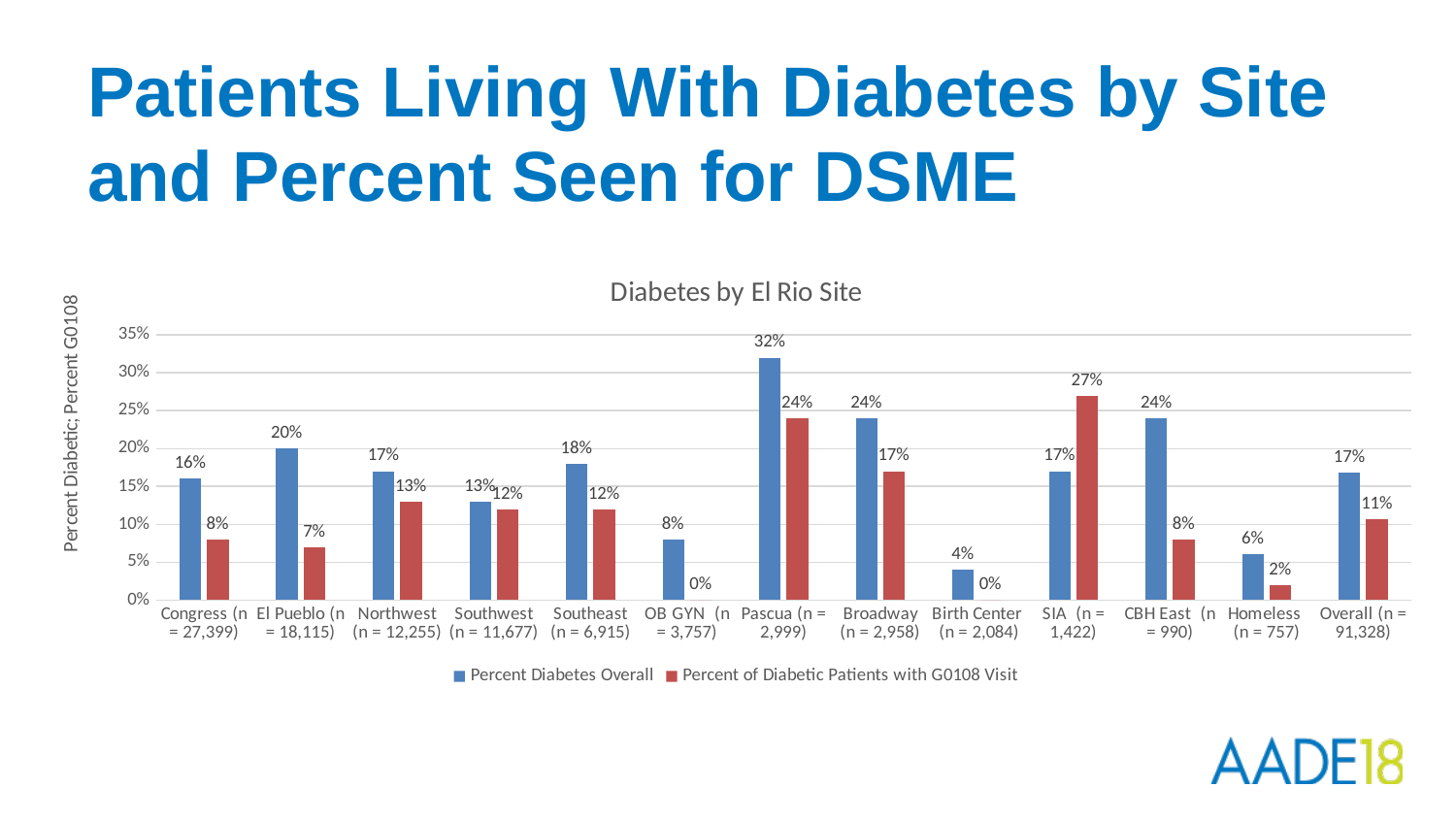
What kind of chart is shown on the slide? Bar chart Which site has the lowest Percent Diabetes Overall? Birth Center Which is larger for SIA: Percent Diabetes Overall or Percent of Diabetic Patients with G0108 Visit? Percent of Diabetic Patients with G0108 Visit What is the Percent of Diabetic Patients with G0108 Visit value for SIA? 27% How many site categories are shown on the x axis? 13 What is the Percent Diabetes Overall value for Pascua? 32% What is the Percent of Diabetic Patients with G0108 Visit value for the Overall category? 11% What is the difference between the Percent Diabetes Overall and the Percent of Diabetic Patients with G0108 Visit for CBH East? 16% Which site has the highest Percent of Diabetic Patients with G0108 Visit? SIA How many series does the legend list? 2 What is the title of the chart? Diabetes by El Rio Site Which site has the highest Percent Diabetes Overall? Pascua